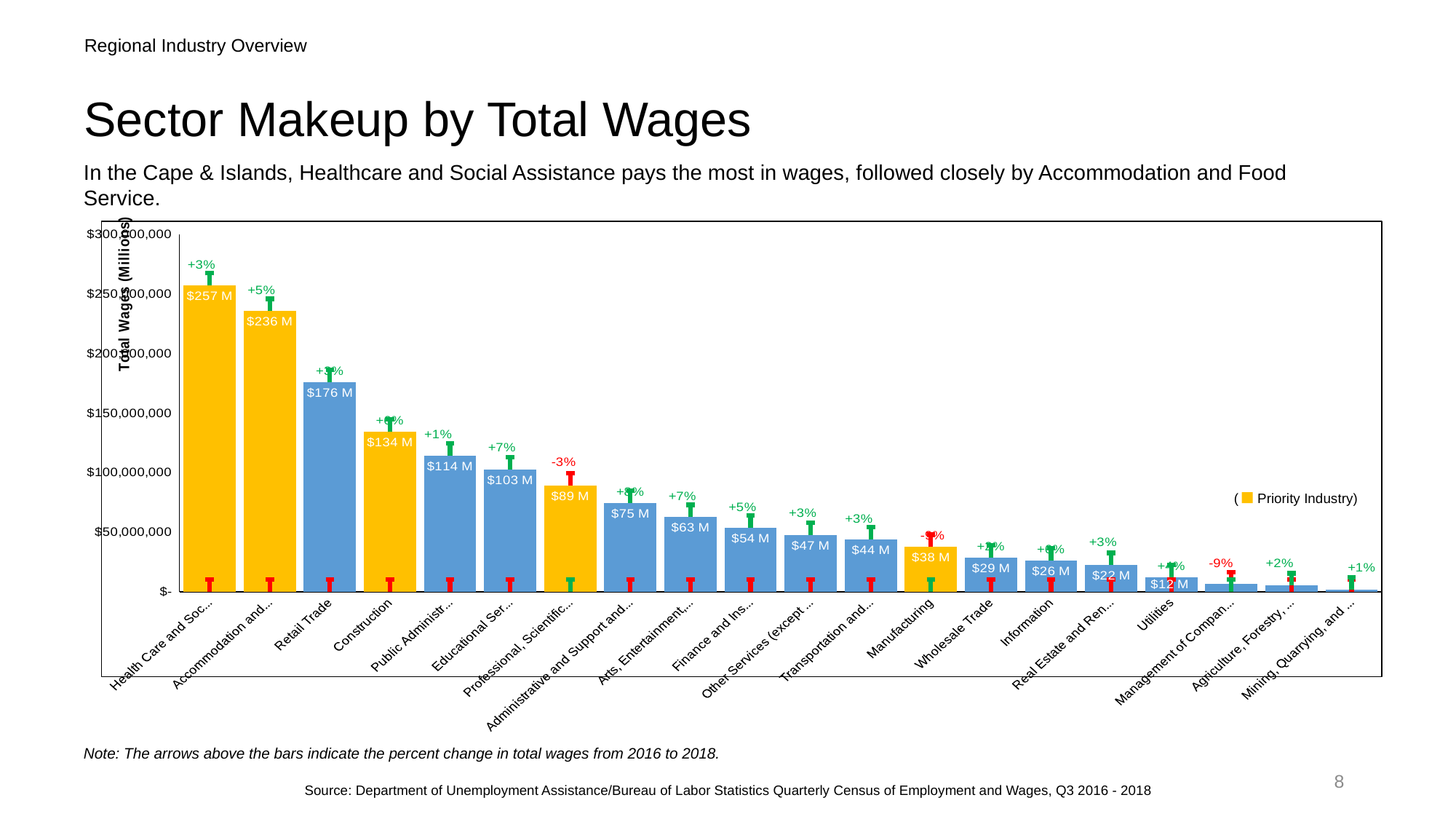
What is the total wages value for Retail Trade? $176 M Is the value for Management of Companies greater or less than $50,000,000? less Which has higher total wages, Construction or Public Administration? Construction How many sectors are shown on the x axis? 20 Which sector has the lowest total wages? Mining, Quarrying and ... What does the yellow bar colour indicate according to the legend? Priority Industry What kind of chart is shown on the slide? Bar chart What is the total wages value for Manufacturing? $38 M Which sector has the highest total wages? Health Care and Social Assistance What percent change in total wages is shown above the Management of Companies bar? -9% What is the difference in total wages between Health Care and Social Assistance and Accommodation and Food Service? $21 M Do the total wages values rise or fall moving left to right along the x axis? Fall